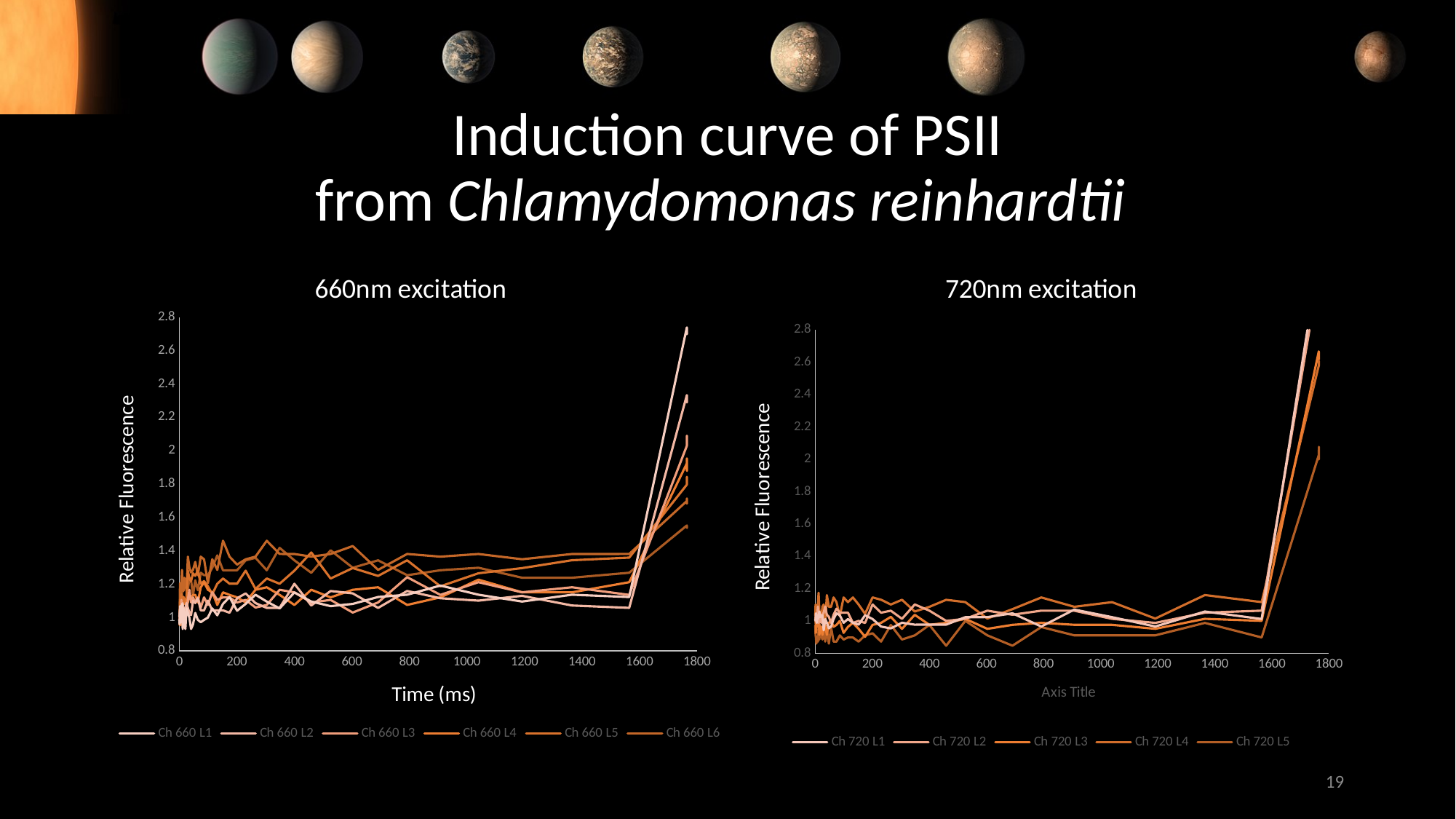
How many series does the legend of the '720nm excitation' chart list? 5 In the '660nm excitation' chart, do the curves rise or fall sharply after about 1600 ms? rise What is the maximum value shown on the y axis of the '660nm excitation' chart? 2.8 What is the y-axis title of the '720nm excitation' chart? Relative Fluorescence How many series does the legend of the '660nm excitation' chart list? 6 What kind of chart is the '660nm excitation' chart? line chart In the '660nm excitation' chart, is the highest value reached at the end of the curves greater or less than 2.6? greater In the '720nm excitation' chart, are the values between 400 ms and 1400 ms greater or less than 1.4? less What kind of chart is the '720nm excitation' chart? line chart In the '720nm excitation' chart, is the lowest value reached at the end of the curves (around 1750 ms) greater or less than 1.8? greater What is the x-axis title of the '660nm excitation' chart? Time (ms)